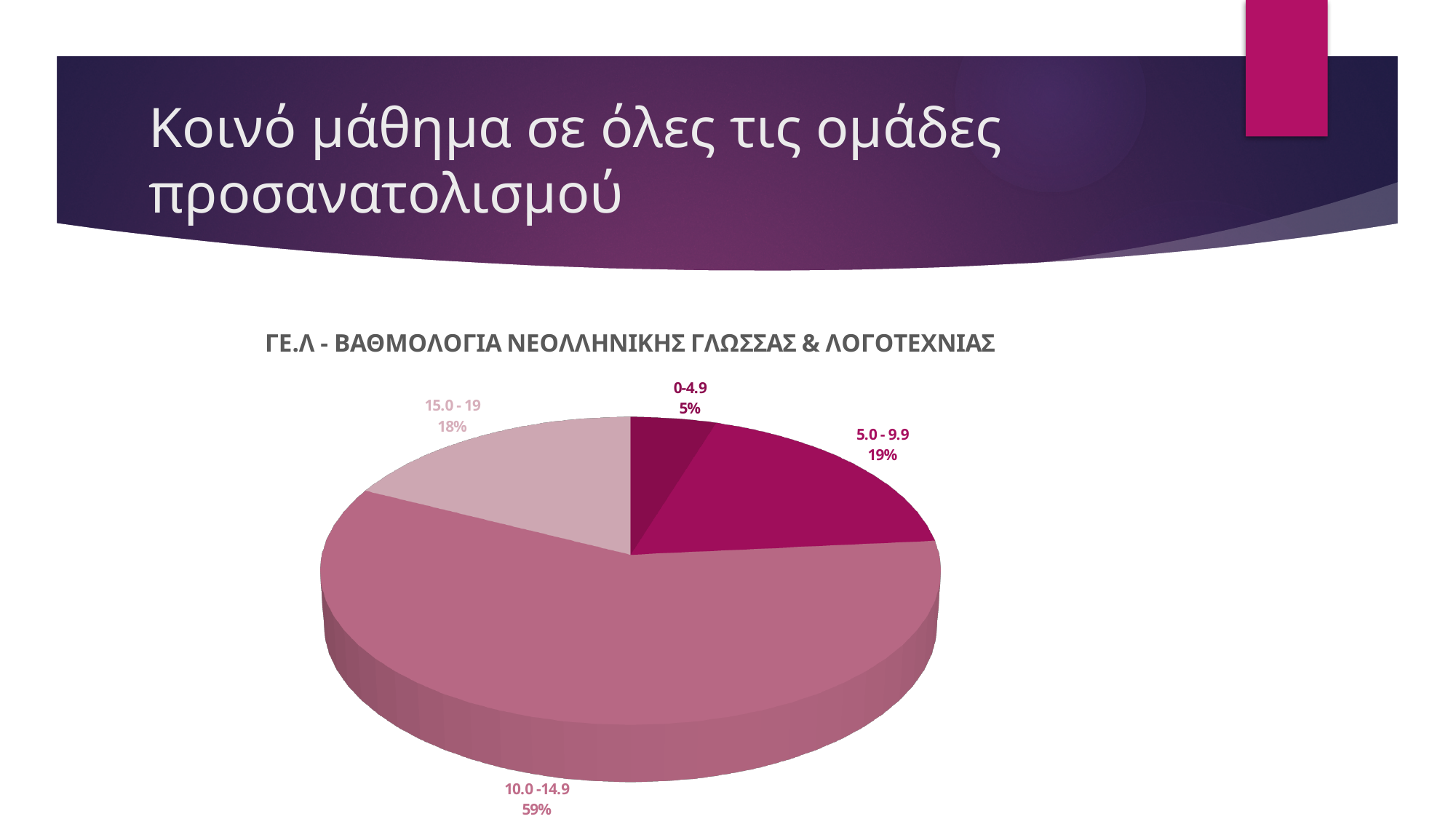
Which grade range has the largest share of the pie? 10.0 -14.9 What share of the pie does the 5.0 - 9.9 slice represent? 19% Which slice is larger, 10.0 -14.9 or 15.0 - 19? 10.0 -14.9 What kind of chart is shown on the slide? Pie chart What share of the pie does the 0-4.9 slice represent? 5% What is the title of the chart? ΓΕ.Λ - ΒΑΘΜΟΛΟΓΙΑ ΝΕΟΛΛΗΝΙΚΗΣ ΓΛΩΣΣΑΣ & ΛΟΓΟΤΕΧΝΙΑΣ What share of the pie does the 15.0 - 19 slice represent? 18% What is the difference in percentage points between the 15.0 - 19 slice and the 0-4.9 slice? 13 How many slices does the pie chart have? 4 Which grade range has the smallest share of the pie? 0-4.9 What is the difference in percentage points between the 10.0 -14.9 slice and the 5.0 - 9.9 slice? 40